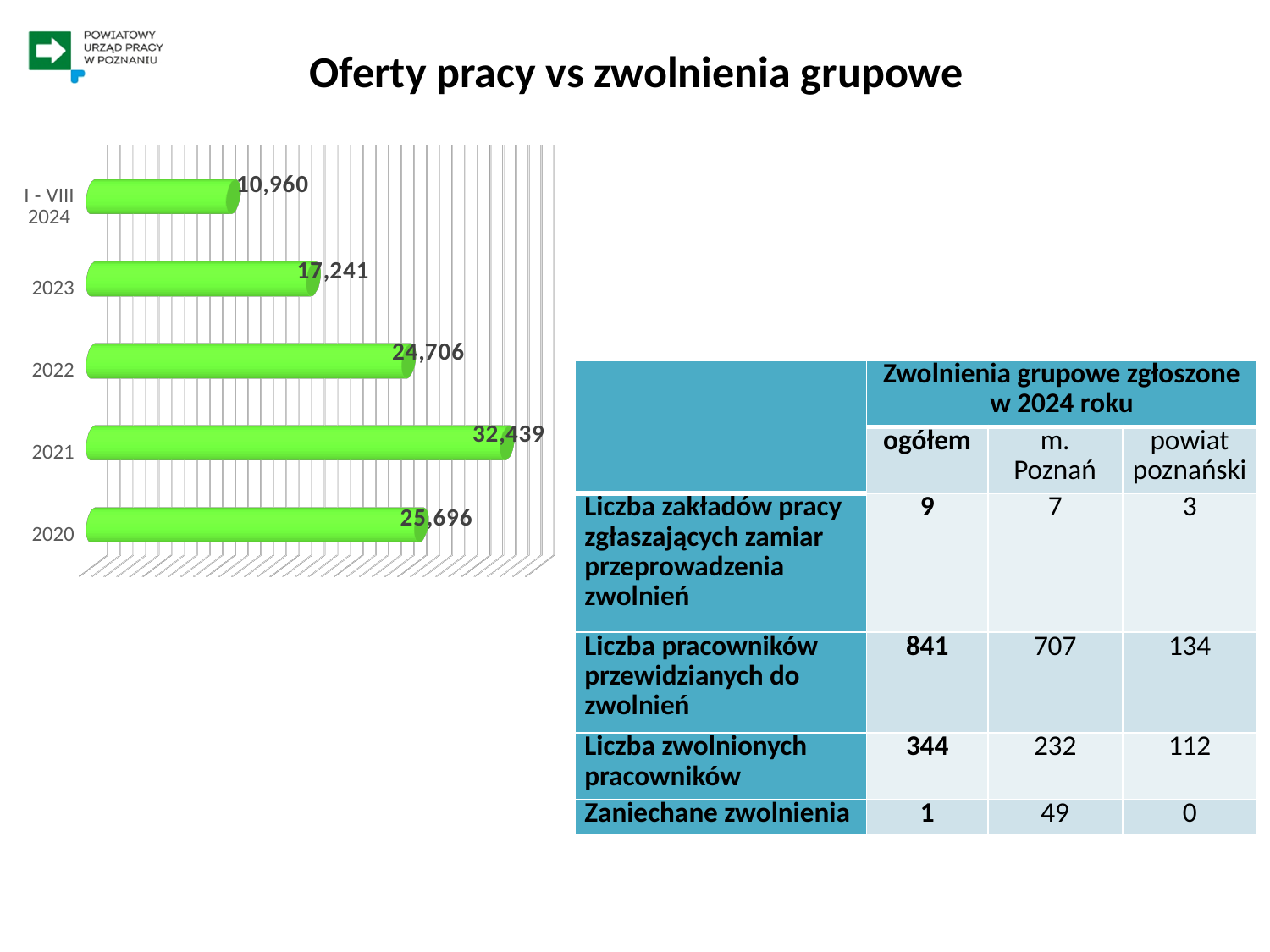
Which year has the highest value in the chart? 2021 What type of chart is shown on the slide? bar chart Which is larger in the chart, the value for 2020 or the value for 2022? 2020 What colour are the bars in the chart? green What is the value for 2021 in the chart? 32,439 How many bars does the chart show? 5 Which category has the lowest value in the chart? I - VIII 2024 What is the value for 2020 in the chart? 25,696 What is the difference between the values for 2021 and 2022 in the chart? 7,733 Do the values in the chart rise or fall from 2021 to I - VIII 2024? fall What is the value for I - VIII 2024 in the chart? 10,960 What is the value for 2023 in the chart? 17,241